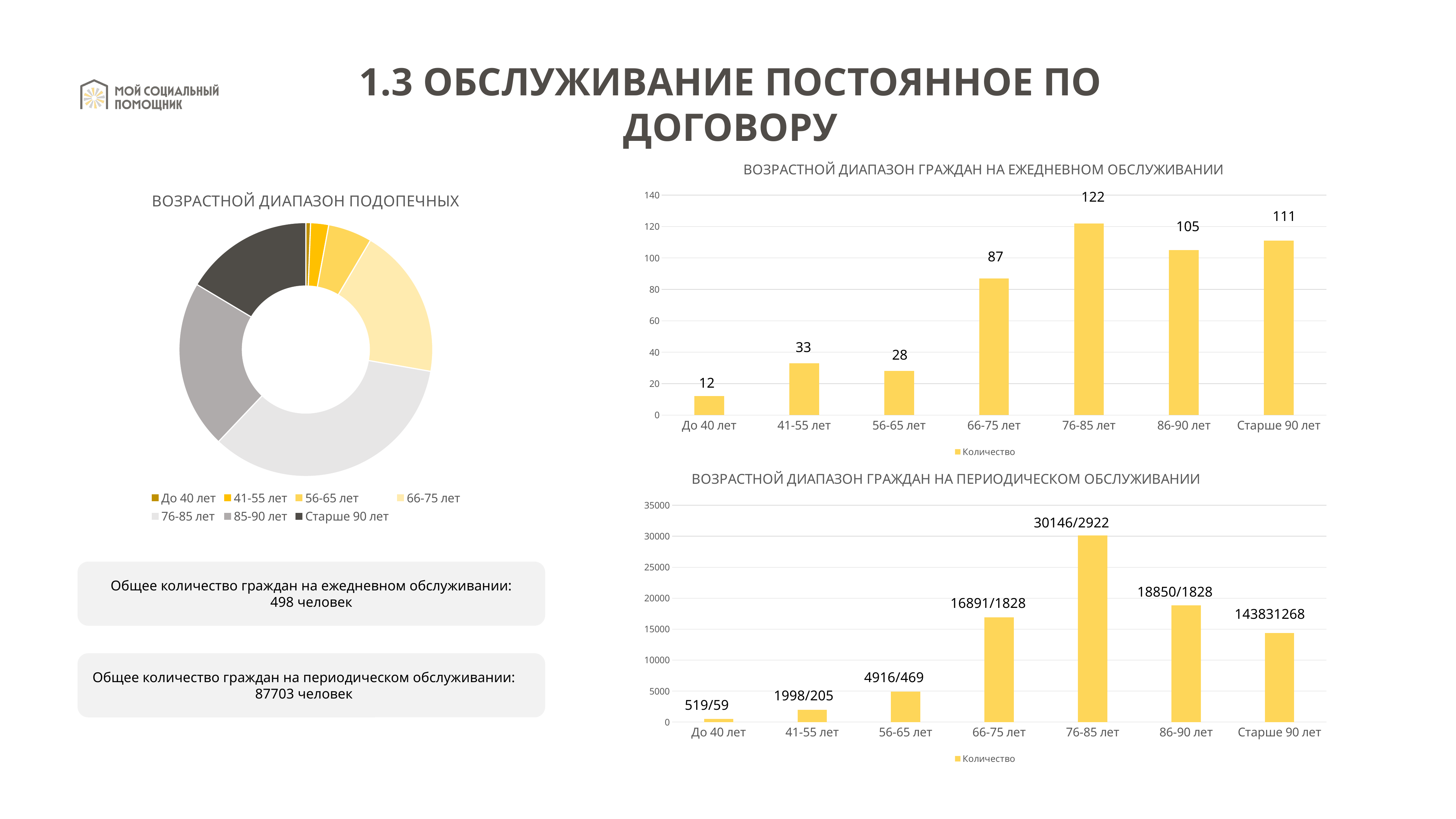
How many series does the legend list in the chart titled "ВОЗРАСТНОЙ ДИАПАЗОН ГРАЖДАН НА ПЕРИОДИЧЕСКОМ ОБСЛУЖИВАНИИ"? 1 What kind of chart is the one titled "ВОЗРАСТНОЙ ДИАПАЗОН ПОДОПЕЧНЫХ"? Donut chart In the chart titled "ВОЗРАСТНОЙ ДИАПАЗОН ГРАЖДАН НА ПЕРИОДИЧЕСКОМ ОБСЛУЖИВАНИИ", what is the data label for 56-65 лет? 4916/469 In the chart titled "ВОЗРАСТНОЙ ДИАПАЗОН ГРАЖДАН НА ЕЖЕДНЕВНОМ ОБСЛУЖИВАНИИ", which age group has the lowest value? До 40 лет In the chart titled "ВОЗРАСТНОЙ ДИАПАЗОН ГРАЖДАН НА ПЕРИОДИЧЕСКОМ ОБСЛУЖИВАНИИ", is the bar for 66-75 лет greater or less than 15000? greater In the chart titled "ВОЗРАСТНОЙ ДИАПАЗОН ГРАЖДАН НА ЕЖЕДНЕВНОМ ОБСЛУЖИВАНИИ", which age group has the highest value? 76-85 лет In the chart titled "ВОЗРАСТНОЙ ДИАПАЗОН ГРАЖДАН НА ЕЖЕДНЕВНОМ ОБСЛУЖИВАНИИ", what is the value for До 40 лет? 12 In the chart titled "ВОЗРАСТНОЙ ДИАПАЗОН ГРАЖДАН НА ЕЖЕДНЕВНОМ ОБСЛУЖИВАНИИ", which is larger: the value for 41-55 лет or for 56-65 лет? 41-55 лет How many age groups are shown in the chart titled "ВОЗРАСТНОЙ ДИАПАЗОН ГРАЖДАН НА ЕЖЕДНЕВНОМ ОБСЛУЖИВАНИИ"? 7 In the chart titled "ВОЗРАСТНОЙ ДИАПАЗОН ГРАЖДАН НА ЕЖЕДНЕВНОМ ОБСЛУЖИВАНИИ", what is the value for 76-85 лет? 122 In the chart titled "ВОЗРАСТНОЙ ДИАПАЗОН ГРАЖДАН НА ПЕРИОДИЧЕСКОМ ОБСЛУЖИВАНИИ", what is the data label for 76-85 лет? 30146/2922 In the chart titled "ВОЗРАСТНОЙ ДИАПАЗОН ГРАЖДАН НА ЕЖЕДНЕВНОМ ОБСЛУЖИВАНИИ", what is the difference between the values for 76-85 лет and 86-90 лет? 17